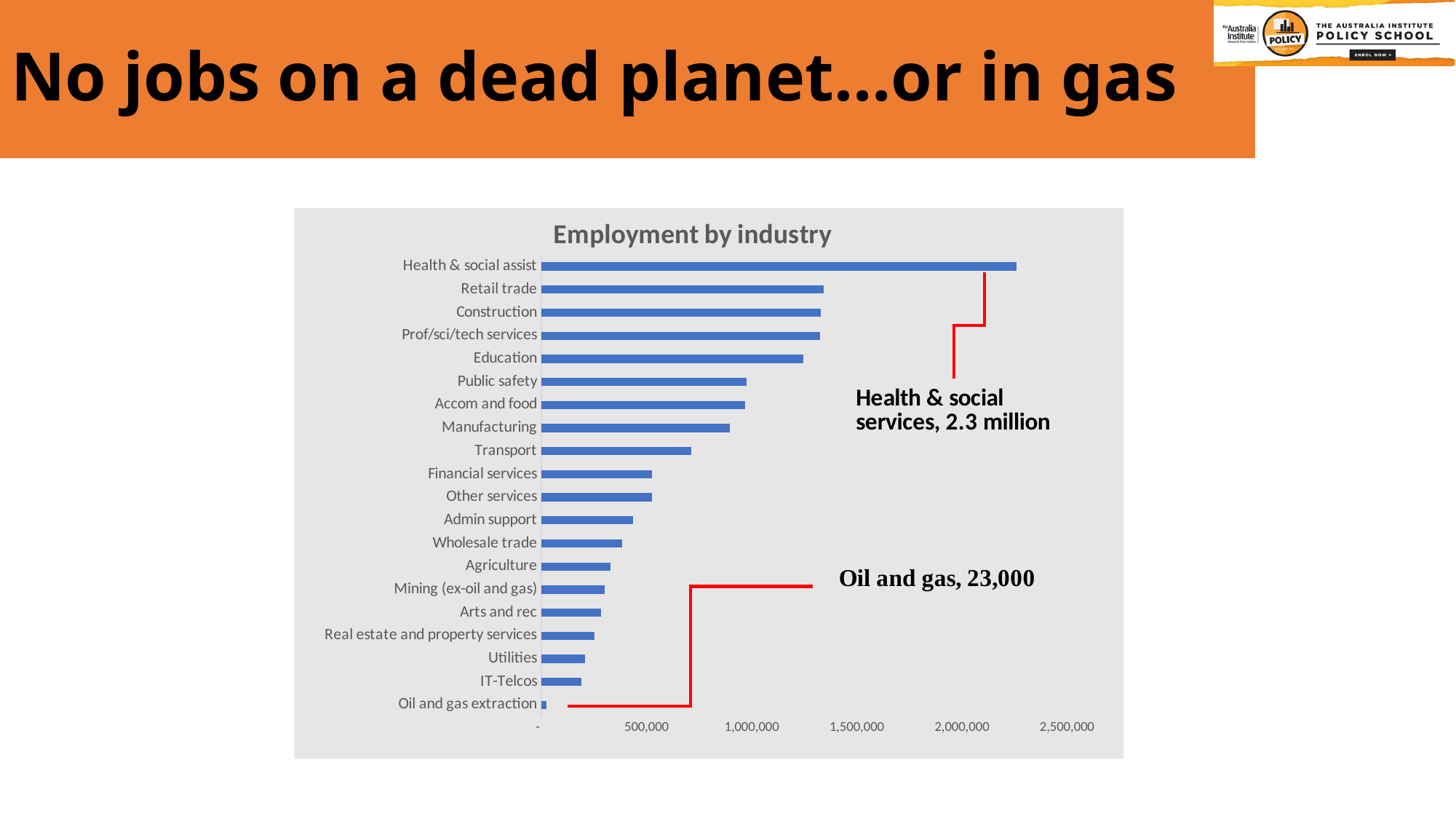
Is the value for Transport greater or less than 1,000,000? less What is the title of the chart? Employment by industry Which industry has the highest employment in the chart? Health & social assist Which has higher employment, Transport or Agriculture? Transport What kind of chart is shown on the slide? Bar chart Which industry has the lowest employment in the chart? Oil and gas extraction How many industries are plotted in the chart? 20 Which has higher employment, Education or Public safety? Education According to the annotation on the chart, how many people are employed in oil and gas? 23,000 According to the annotation on the chart, how many people are employed in health & social services? 2.3 million Is the value for Education greater or less than 1,000,000? greater Is the value for Wholesale trade greater or less than 500,000? less